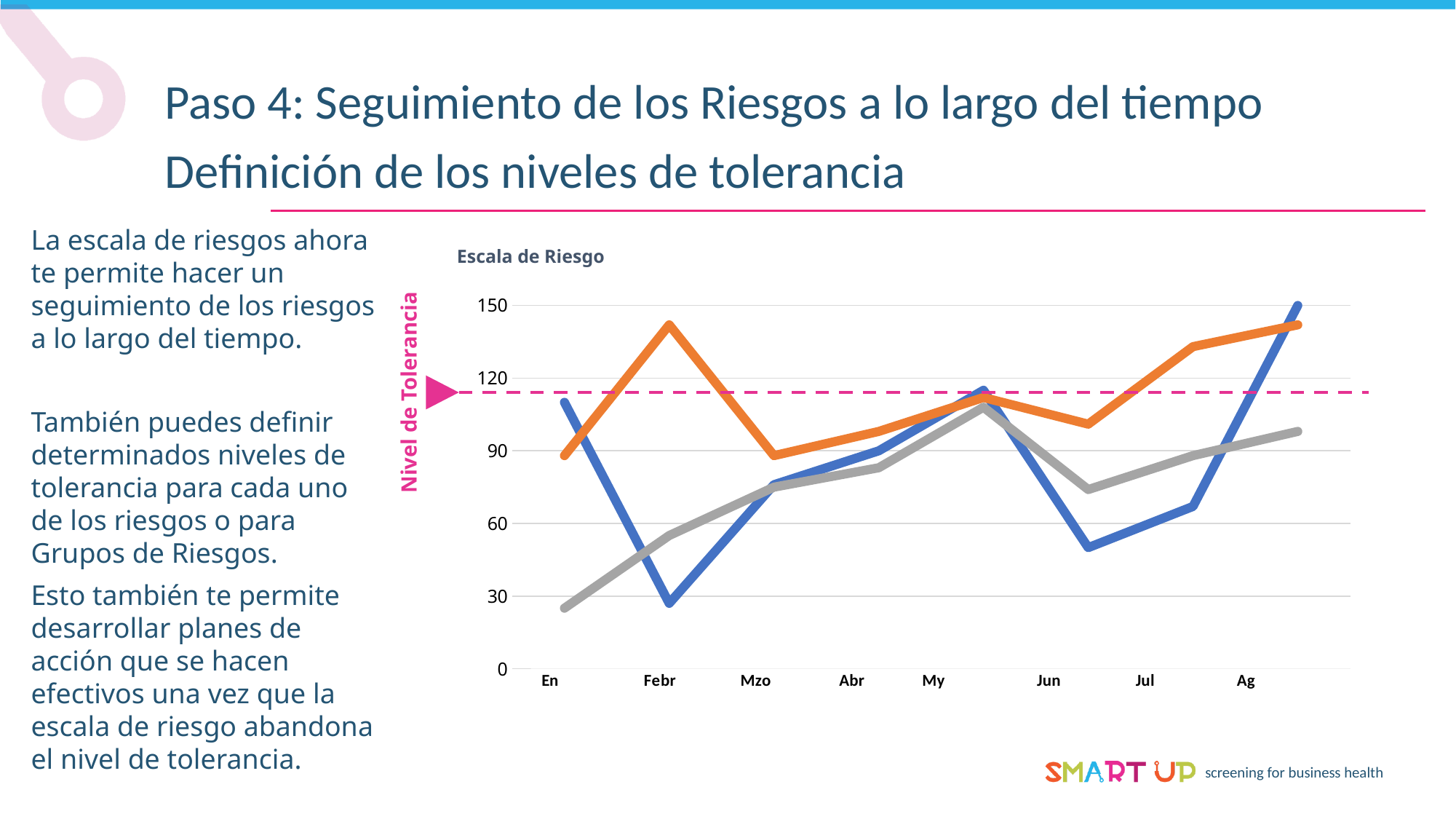
What is the title of the chart? Escala de Riesgo How many lines (series) are plotted in the chart, not counting the dashed tolerance line? 3 Is the value of the gray line at Jun greater or less than 60? greater How many month categories are shown on the x axis of the chart? 8 Is the value of the orange line at Febr greater or less than 120? greater What kind of chart is shown on the slide? line chart At which month does the blue line reach its highest value? Ag At Febr, which line has the larger value, the orange line or the blue line? orange line What label is written along the vertical axis of the chart? Nivel de Tolerancia At which month does the blue line reach its lowest value? Febr Does the blue line rise or fall from Jun to Ag? rise Is the value of the blue line at Jun greater or less than 60? less